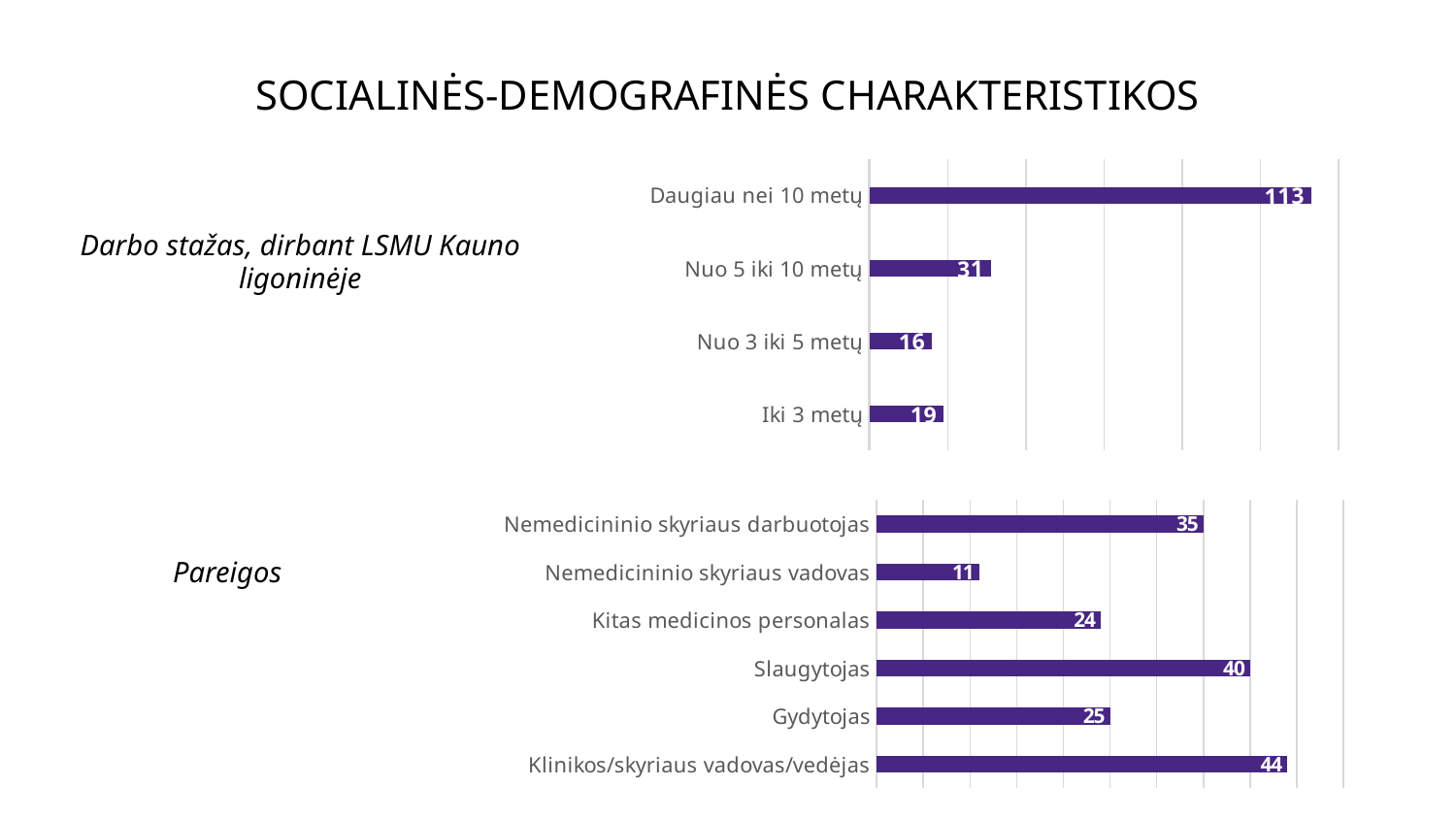
In the 'Darbo stažas, dirbant LSMU Kauno ligoninėje' chart, what is the difference between 'Nuo 5 iki 10 metų' and 'Iki 3 metų'? 12 In the 'Pareigos' chart, what is the value for 'Nemedicininio skyriaus vadovas'? 11 In the 'Darbo stažas, dirbant LSMU Kauno ligoninėje' chart, what is the value for 'Daugiau nei 10 metų'? 113 What type of chart is the 'Pareigos' chart? Bar chart In the 'Darbo stažas, dirbant LSMU Kauno ligoninėje' chart, which category has the lowest value? Nuo 3 iki 5 metų In the 'Pareigos' chart, which is larger: 'Gydytojas' or 'Kitas medicinos personalas'? Gydytojas In the 'Pareigos' chart, what is the value for 'Slaugytojas'? 40 How many categories does the 'Pareigos' chart show? 6 In the 'Pareigos' chart, which category has the highest value? Klinikos/skyriaus vadovas/vedėjas In the 'Darbo stažas, dirbant LSMU Kauno ligoninėje' chart, what is the value for 'Nuo 3 iki 5 metų'? 16 In the 'Darbo stažas, dirbant LSMU Kauno ligoninėje' chart, which category has the highest value? Daugiau nei 10 metų How many categories does the 'Darbo stažas, dirbant LSMU Kauno ligoninėje' chart show? 4